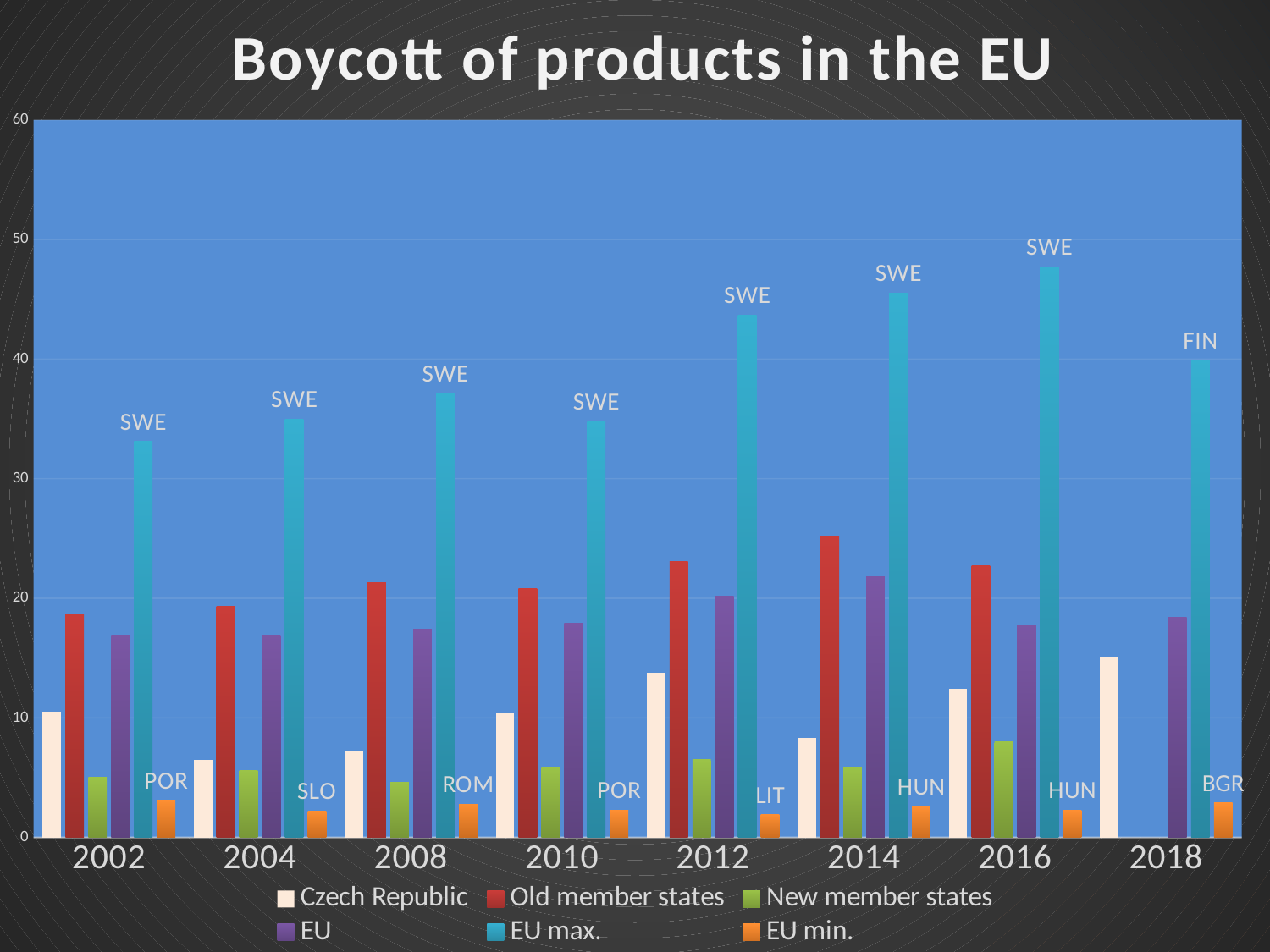
Which country is labelled as the EU min. in 2012? LIT Which is larger: the EU max. value for 2016 or for 2018? 2016 What is the title of the chart? Boycott of products in the EU Is the EU max. value for 2016 greater or less than 40? greater In which year is the Old member states bar the highest? 2014 How many years are shown on the x axis of the chart? 8 How many series does the legend list? 6 Is the Czech Republic value for 2018 greater or less than 10? greater In which year is the EU max. bar the highest? 2016 Which country is labelled as the EU max. in 2018? FIN What kind of chart is shown on the slide? bar chart In 2012, which is larger: the Old member states value or the EU value? Old member states